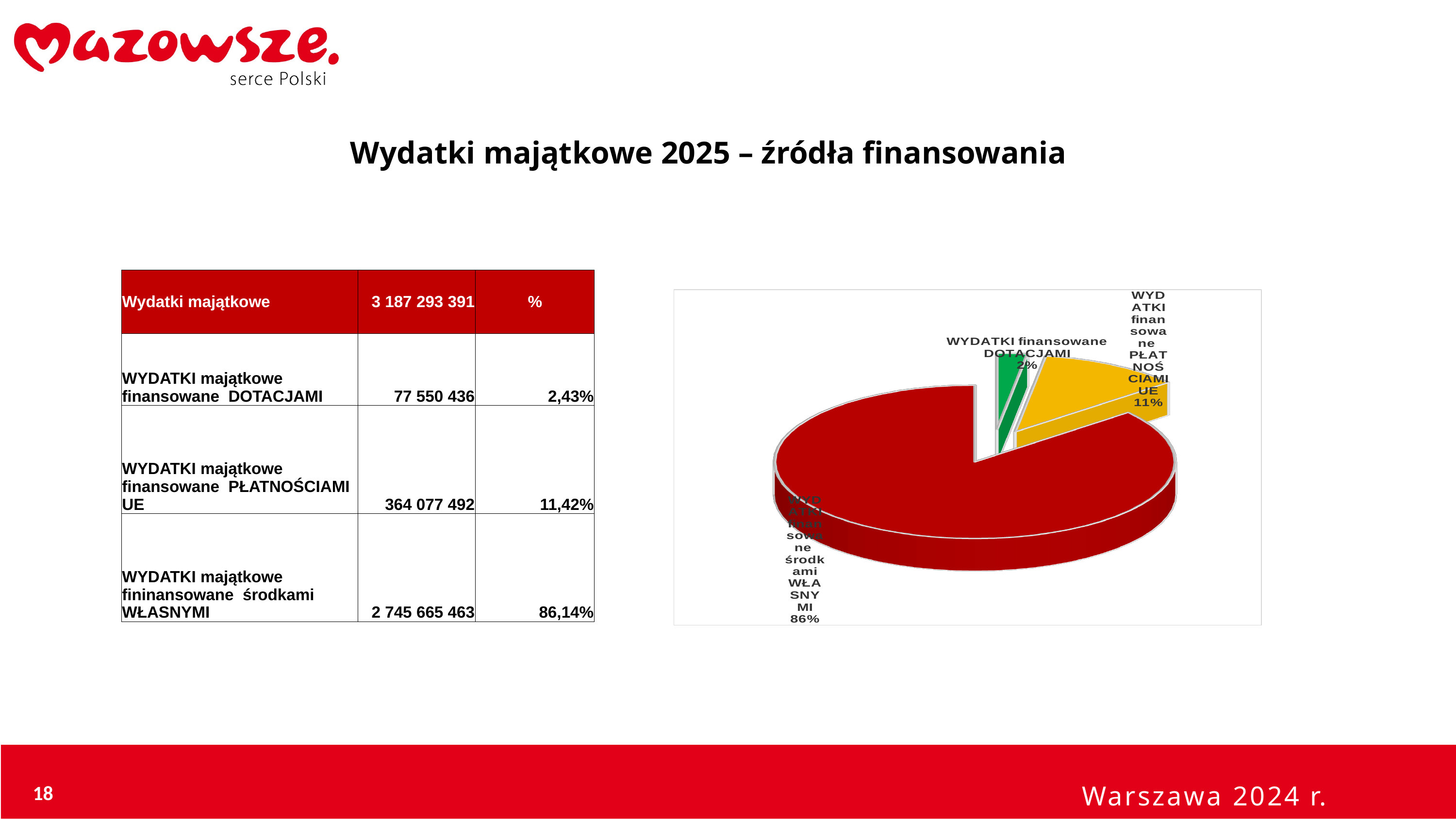
In the pie chart, what is the difference in percentage points between the PŁATNOŚCIAMI UE slice and the DOTACJAMI slice? 9 What share of the pie chart is labelled for WYDATKI finansowane PŁATNOŚCIAMI UE? 11% What colour is the slice for WYDATKI finansowane DOTACJAMI in the pie chart? green What share of the pie chart is labelled for WYDATKI finansowane DOTACJAMI? 2% In the pie chart, what is the difference in percentage points between the środkami WŁASNYMI slice and the PŁATNOŚCIAMI UE slice? 75 What kind of chart is shown on the right side of the slide? pie chart In the pie chart, which is larger: the slice for PŁATNOŚCIAMI UE or the slice for DOTACJAMI? PŁATNOŚCIAMI UE What colour is the largest slice of the pie chart? red What share of the pie chart is labelled for WYDATKI finansowane środkami WŁASNYMI? 86% How many slices does the pie chart have? 3 Which slice of the pie chart is the largest? WYDATKI finansowane środkami WŁASNYMI Which slice of the pie chart is the smallest? WYDATKI finansowane DOTACJAMI